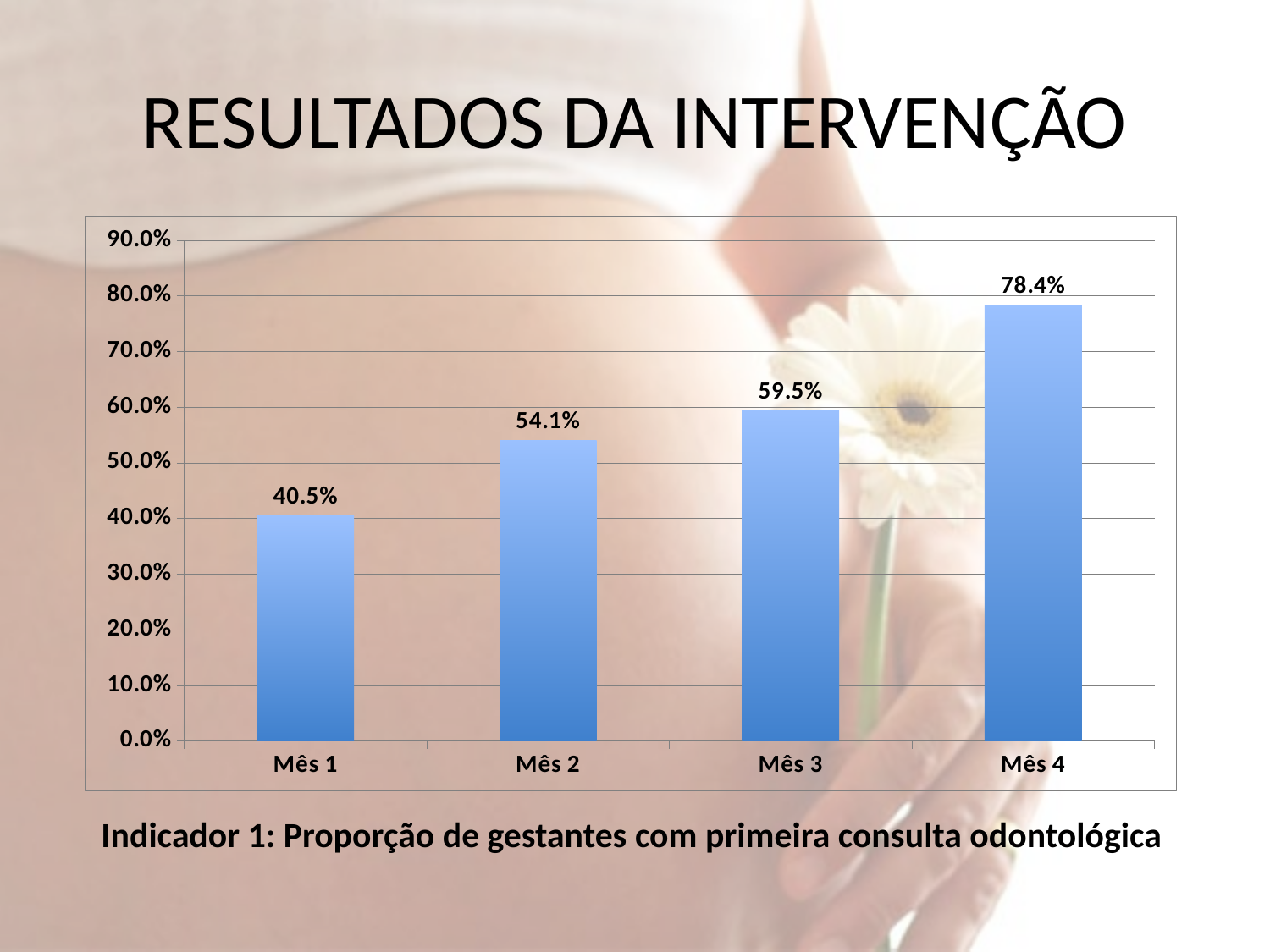
What is the value for Mês 1? 40.5% Which is larger, the value for Mês 2 or the value for Mês 3? Mês 3 What kind of chart is shown on the slide? bar chart What is the value for Mês 3? 59.5% Which month has the highest value? Mês 4 Is the value for Mês 2 greater or less than 50.0%? greater How many months are shown on the x axis? 4 What is the difference between the values for Mês 4 and Mês 1? 37.9% Do the values rise or fall from Mês 1 to Mês 4? rise What is the difference between the values for Mês 2 and Mês 1? 13.6% Which month has the lowest value? Mês 1 What is the value for Mês 4? 78.4%